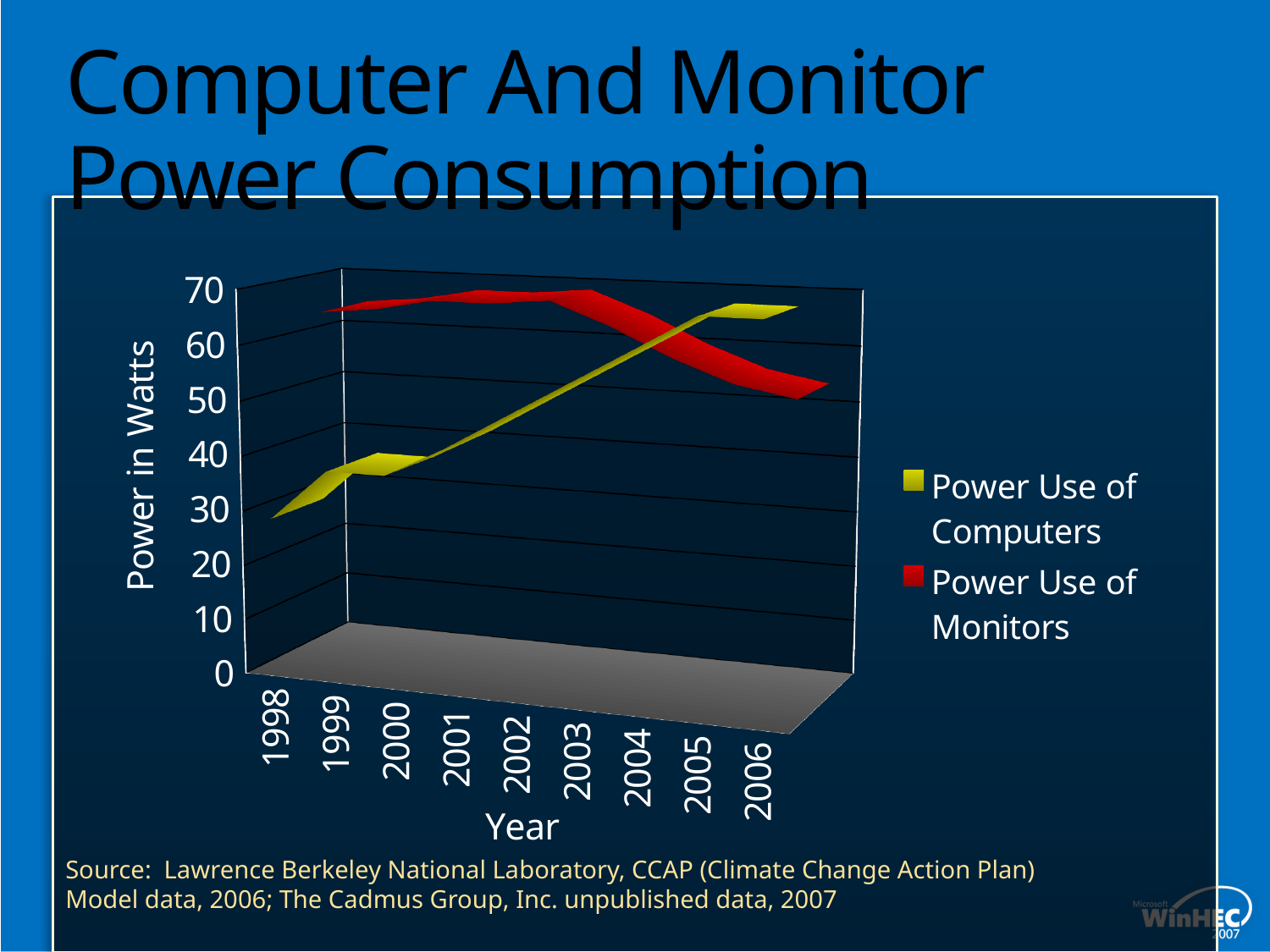
In 2006, which series has the higher value: Power Use of Computers or Power Use of Monitors? Power Use of Computers What is the title of the vertical axis? Power in Watts In 1998, which series has the higher value: Power Use of Computers or Power Use of Monitors? Power Use of Monitors How many years are shown along the x axis? 9 How many series does the legend list? 2 What kind of chart is shown on the slide? Line chart Which colour represents Power Use of Monitors in the legend? Red Does the Power Use of Monitors series rise or fall from 2003 to 2006? Fall Is the value for Power Use of Monitors in 1998 greater or less than 60? greater Is the value for Power Use of Computers in 1998 greater or less than 40? less Does the Power Use of Computers series rise or fall from 1998 to 2006? Rise Is the value for Power Use of Computers in 2006 greater or less than 50? greater